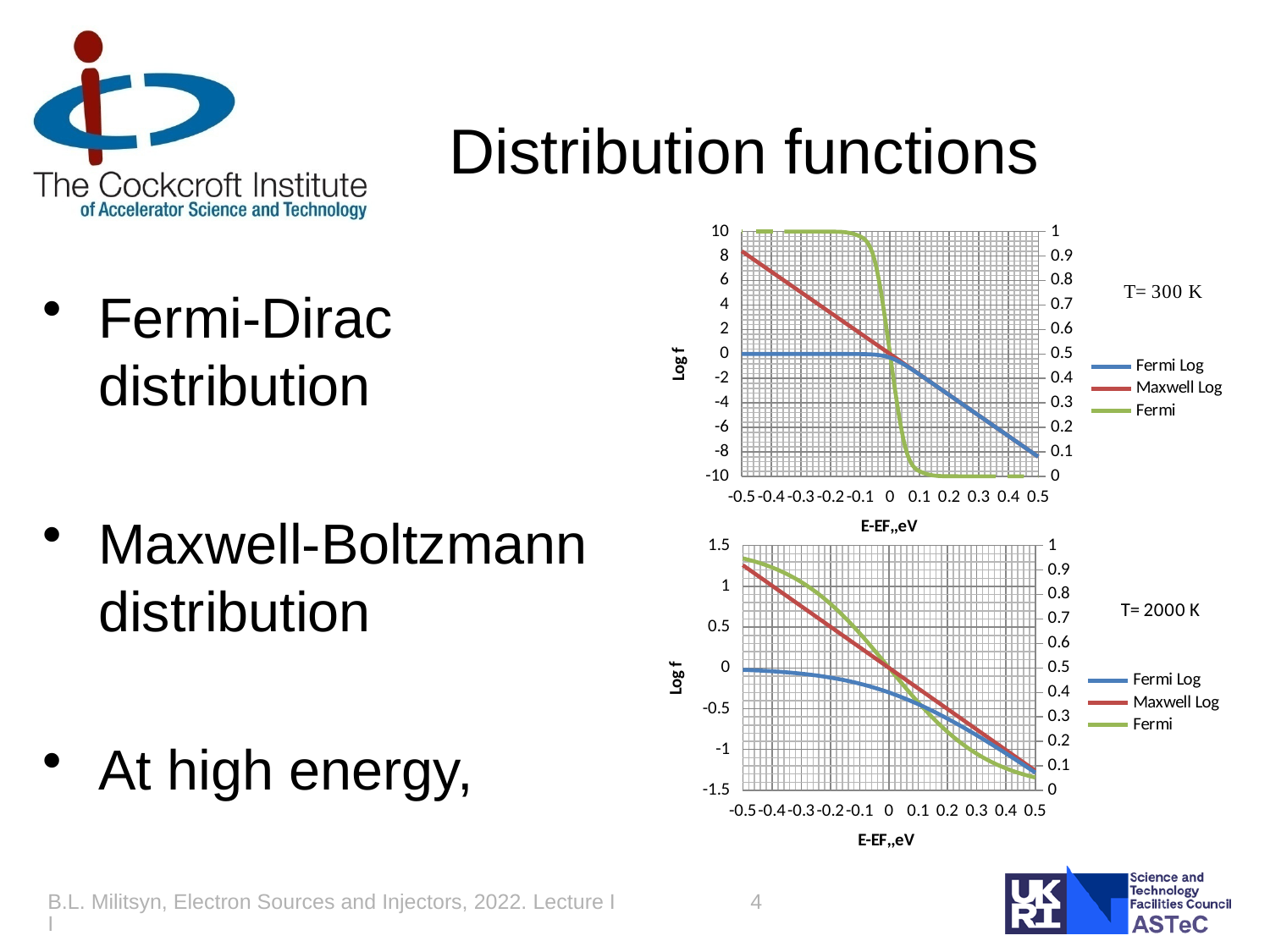
How many series does the legend of the top chart (T= 300 K) list? 3 In the top chart (T= 300 K), does the Maxwell Log line rise or fall as E-EF increases from -0.5 to 0.5? fall In the bottom chart (T= 2000 K), is the Log f value of the Maxwell Log line at E-EF = -0.5 greater or less than 1? greater In the top chart (T= 300 K), is the Log f value of the Fermi Log line at E-EF = 0.5 greater or less than -6? less What kind of chart is the top chart (T= 300 K)? line chart In the top chart (T= 300 K), is the Log f value of the Maxwell Log line at E-EF = -0.5 greater or less than 6? greater In the top chart (T= 300 K), at E-EF = -0.3, which line has the higher Log f value, Maxwell Log or Fermi Log? Maxwell Log In the bottom chart (T= 2000 K), does the Fermi line rise or fall as E-EF increases from -0.5 to 0.5? fall What temperature is labelled next to the top chart? T= 300 K How many series does the legend of the bottom chart (T= 2000 K) list? 3 What are the three legend entries of the bottom chart (T= 2000 K)? Fermi Log, Maxwell Log, Fermi